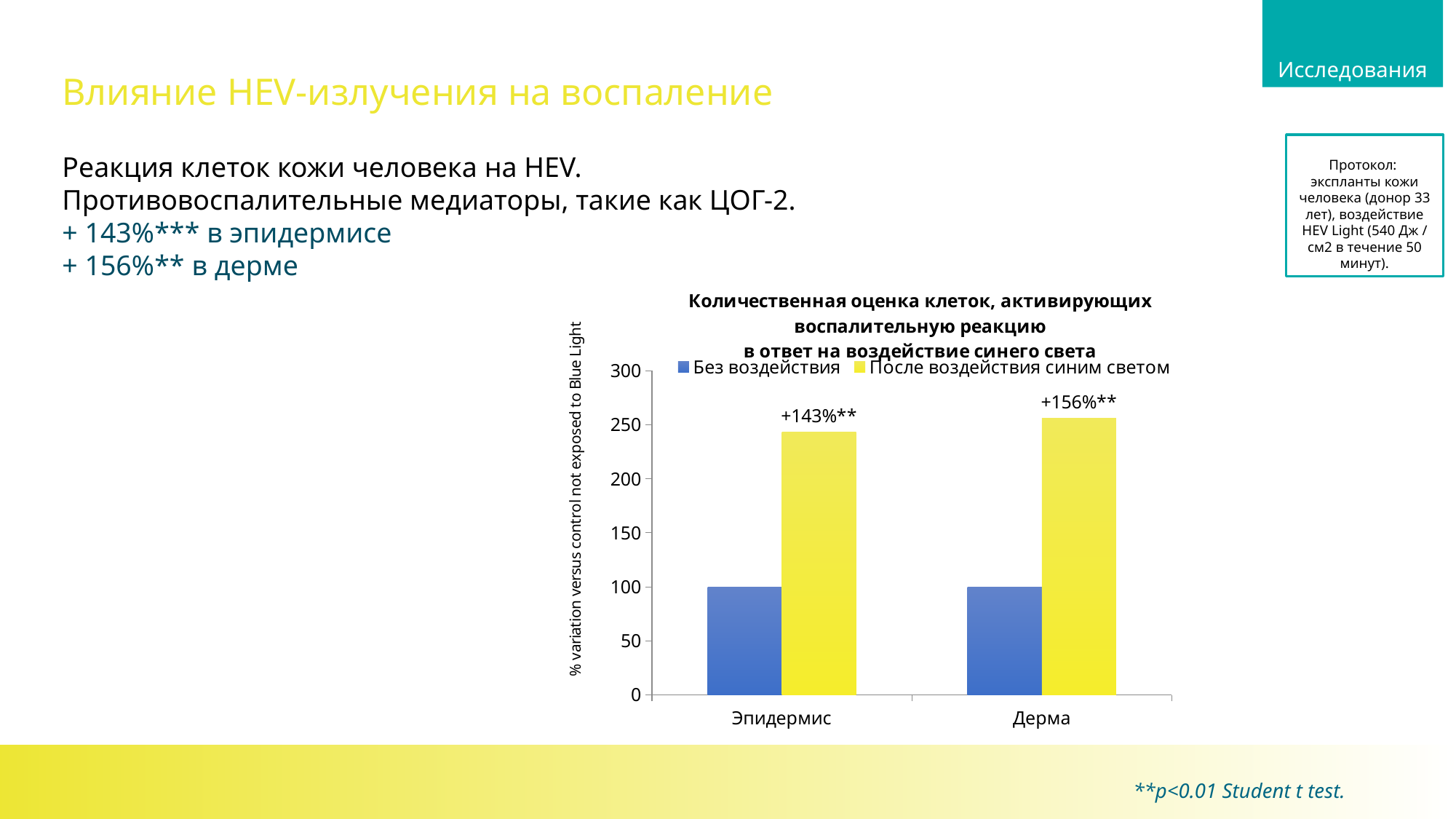
What is the value of the 'Без воздействия' bar for Эпидермис? 100 Is the value of the 'После воздействия синим светом' bar for Эпидермис greater or less than 200? greater How many series does the chart legend list? 2 Which category has the higher 'После воздействия синим светом' bar, Эпидермис or Дерма? Дерма For Дерма, which series has the larger value, 'Без воздействия' or 'После воздействия синим светом'? После воздействия синим светом What label is printed above the 'После воздействия синим светом' bar for Дерма? +156%** Is the value of the 'После воздействия синим светом' bar for Эпидермис greater or less than 300? less What label is printed above the 'После воздействия синим светом' bar for Эпидермис? +143%** Is the value of the 'После воздействия синим светом' bar for Дерма greater or less than 200? greater How many categories are shown on the x axis of the chart? 2 What is the value of the 'Без воздействия' bar for Дерма? 100 What kind of chart is shown on the slide? bar chart